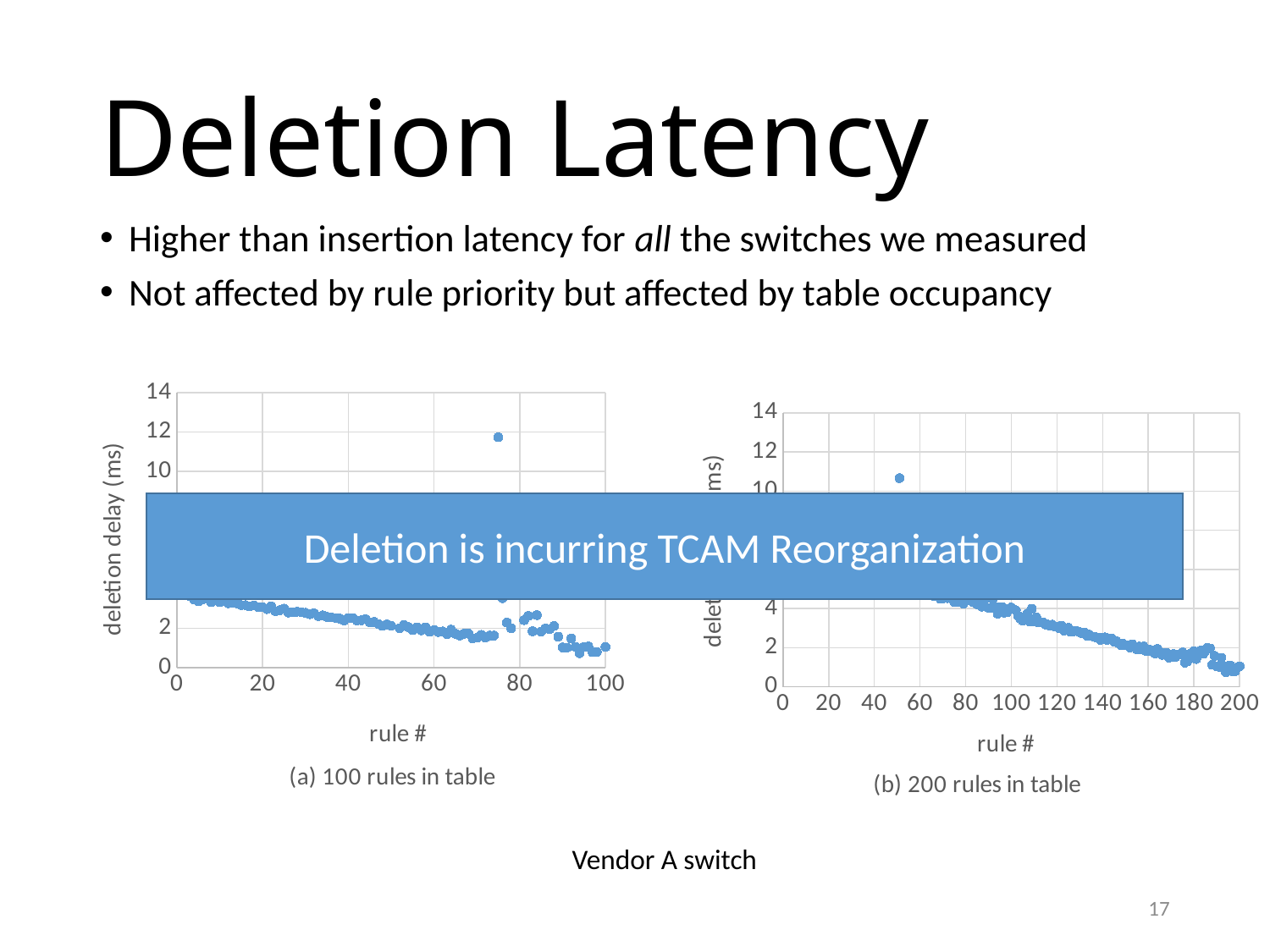
In chart (b) 200 rules in table, is the highest plotted deletion delay greater or less than 10 ms? greater What kind of chart is chart (b) 200 rules in table? scatter chart In chart (a) 100 rules in table, is the highest plotted deletion delay greater or less than 10 ms? greater In chart (a) 100 rules in table, is the deletion delay for the last rule (rule # 100) greater or less than 2 ms? less What is the maximum value shown on the x axis of chart (b) 200 rules in table? 200 How many charts are shown on the slide? 2 In chart (b) 200 rules in table, do the deletion delay values generally rise or fall as the rule # increases? fall What kind of chart is chart (a) 100 rules in table? scatter chart In chart (a) 100 rules in table, do the deletion delay values generally rise or fall as the rule # increases? fall What is the label of the x axis in chart (a) 100 rules in table? rule #